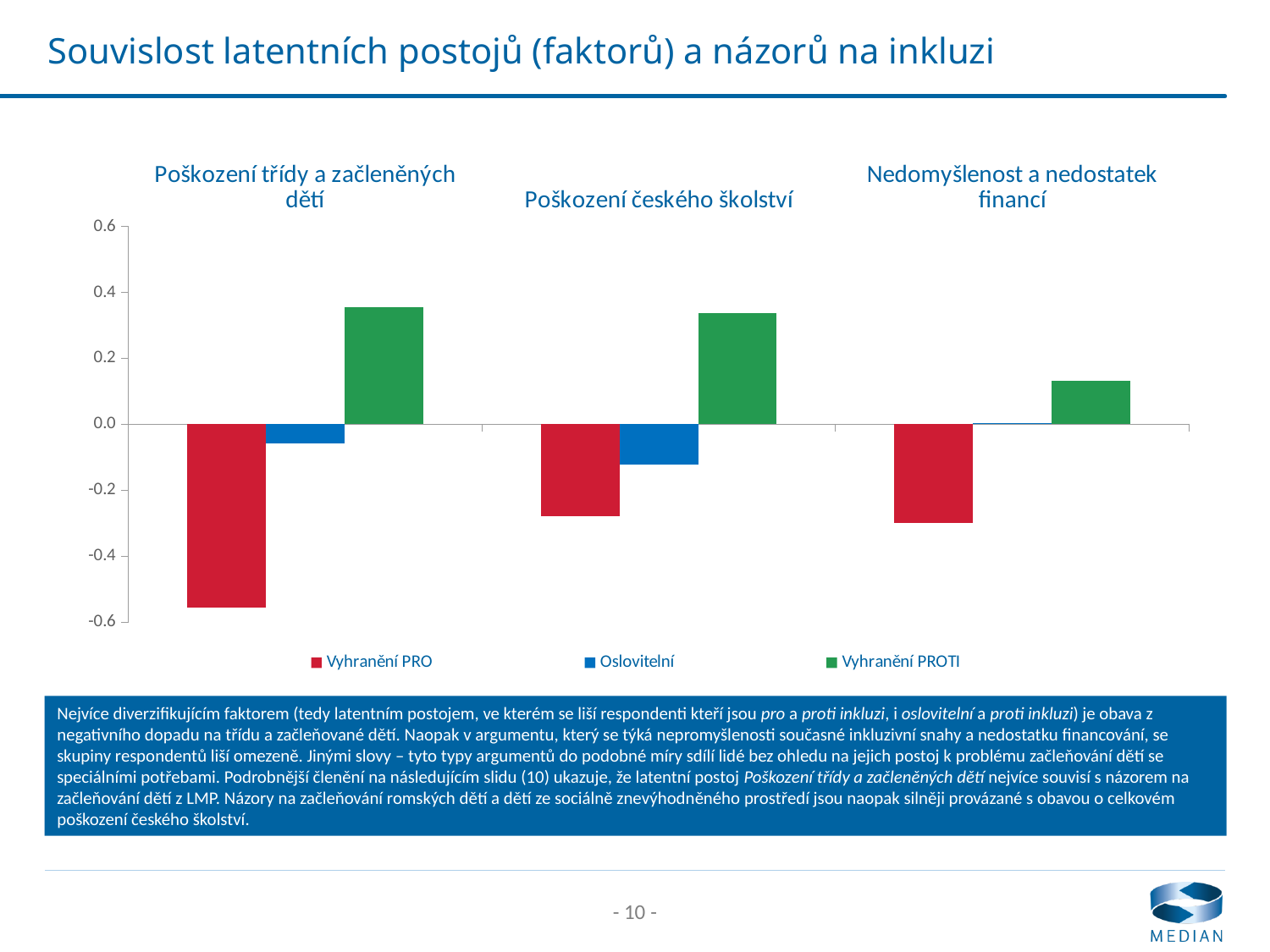
Which category group has the lowest value for Vyhranění PRO? Poškození třídy a začleněných dětí For Vyhranění PROTI, which is larger: the value in Poškození třídy a začleněných dětí or in Nedomyšlenost a nedostatek financí? Poškození třídy a začleněných dětí How many series does the legend list? 3 Which series is shown in green? Vyhranění PROTI How many category groups are plotted on the chart? 3 Is the value for Oslovitelní in the group Poškození českého školství greater or less than -0.2? greater Which series is shown in red? Vyhranění PRO What kind of chart is shown on the slide? bar chart Is the value for Vyhranění PROTI in the group Nedomyšlenost a nedostatek financí greater or less than 0.2? less Is the value for Vyhranění PRO in the group Poškození třídy a začleněných dětí greater or less than -0.4? less Which series has the highest value in the group Nedomyšlenost a nedostatek financí? Vyhranění PROTI